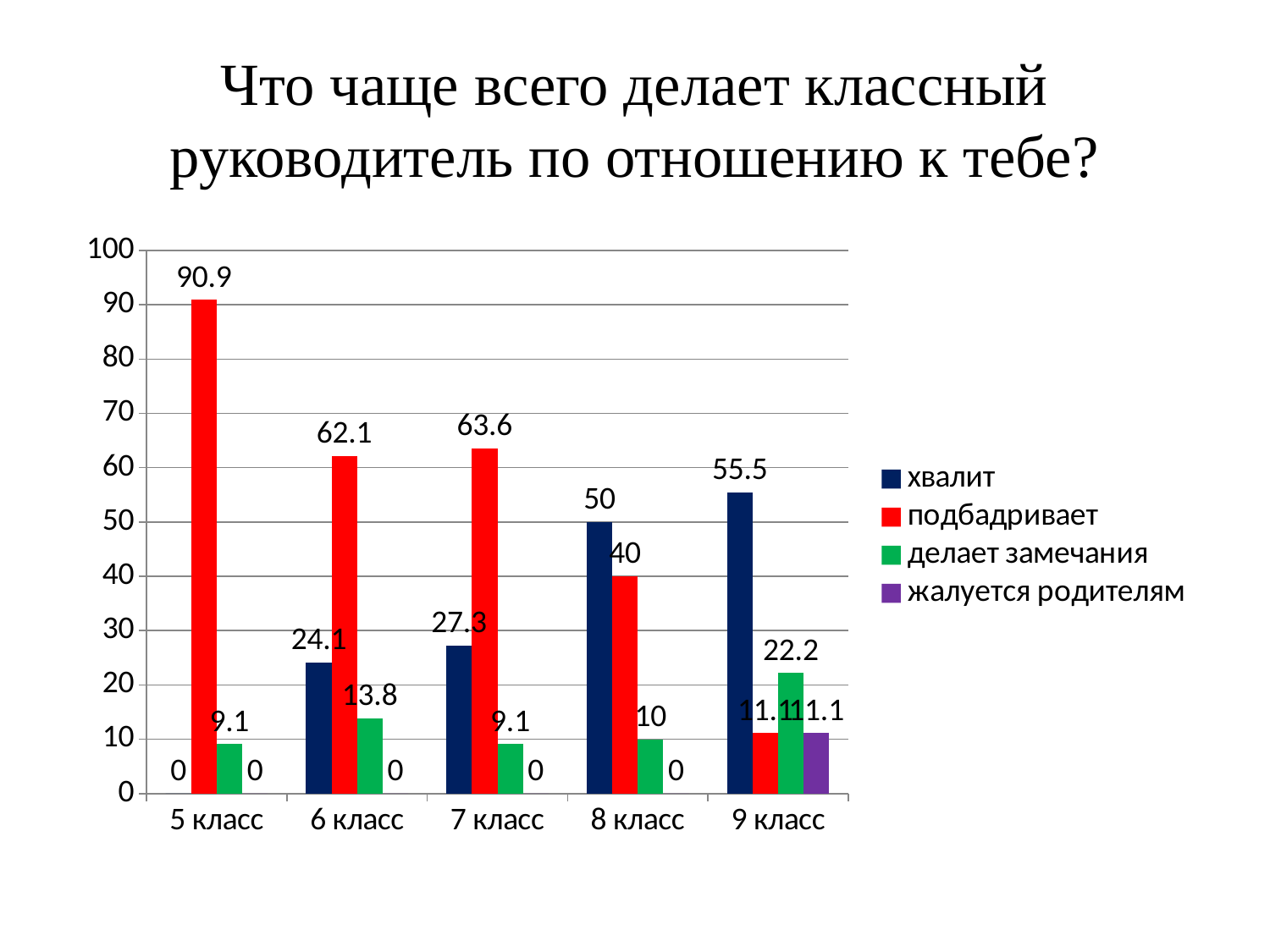
How many class categories are shown on the x axis? 5 What is the difference between подбадривает and хвалит in 7 класс? 36.3 How many series does the legend list? 4 What is the value for подбадривает in 8 класс? 40 Which class has the highest value for подбадривает? 5 класс What is the value for делает замечания in 9 класс? 22.2 What is the value for подбадривает in 5 класс? 90.9 What is the value for хвалит in 6 класс? 24.1 Which class has the highest value for хвалит? 9 класс What type of chart is shown on the slide? bar chart Which series is shown in red in the legend? подбадривает In 8 класс, which is larger: хвалит or подбадривает? хвалит